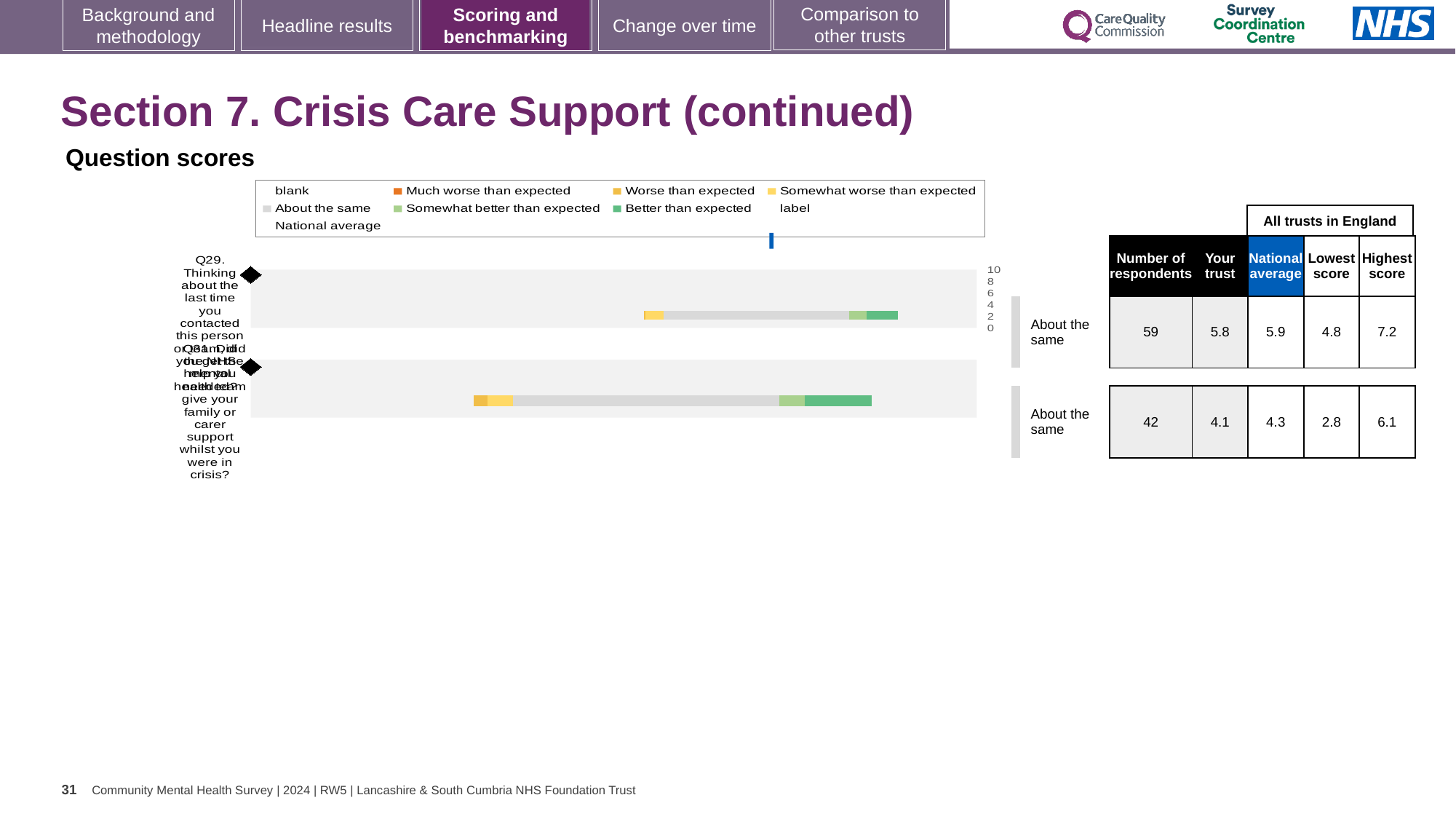
In the table beside the chart, what is the 'Your trust' score for Q29? 5.8 In the table beside the chart, how many respondents answered Q31? 42 Which question has the higher 'Your trust' score in the table beside the chart, Q29 or Q31? Q29 In the table beside the chart, how many respondents answered Q29? 59 In the table beside the chart, what is the national average for Q31? 4.3 In the table beside the chart, what is the 'Your trust' score for Q31? 4.1 How many survey questions are plotted as bars in the chart? 2 What kind of chart is shown under 'Question scores'? bar chart What is the difference between the highest score and the lowest score for Q31 in the table beside the chart? 3.3 What is the highest tick value shown on the chart's axis? 10 Which two question numbers are plotted in the chart? Q29 and Q31 In the table beside the chart, what is the national average for Q29? 5.9